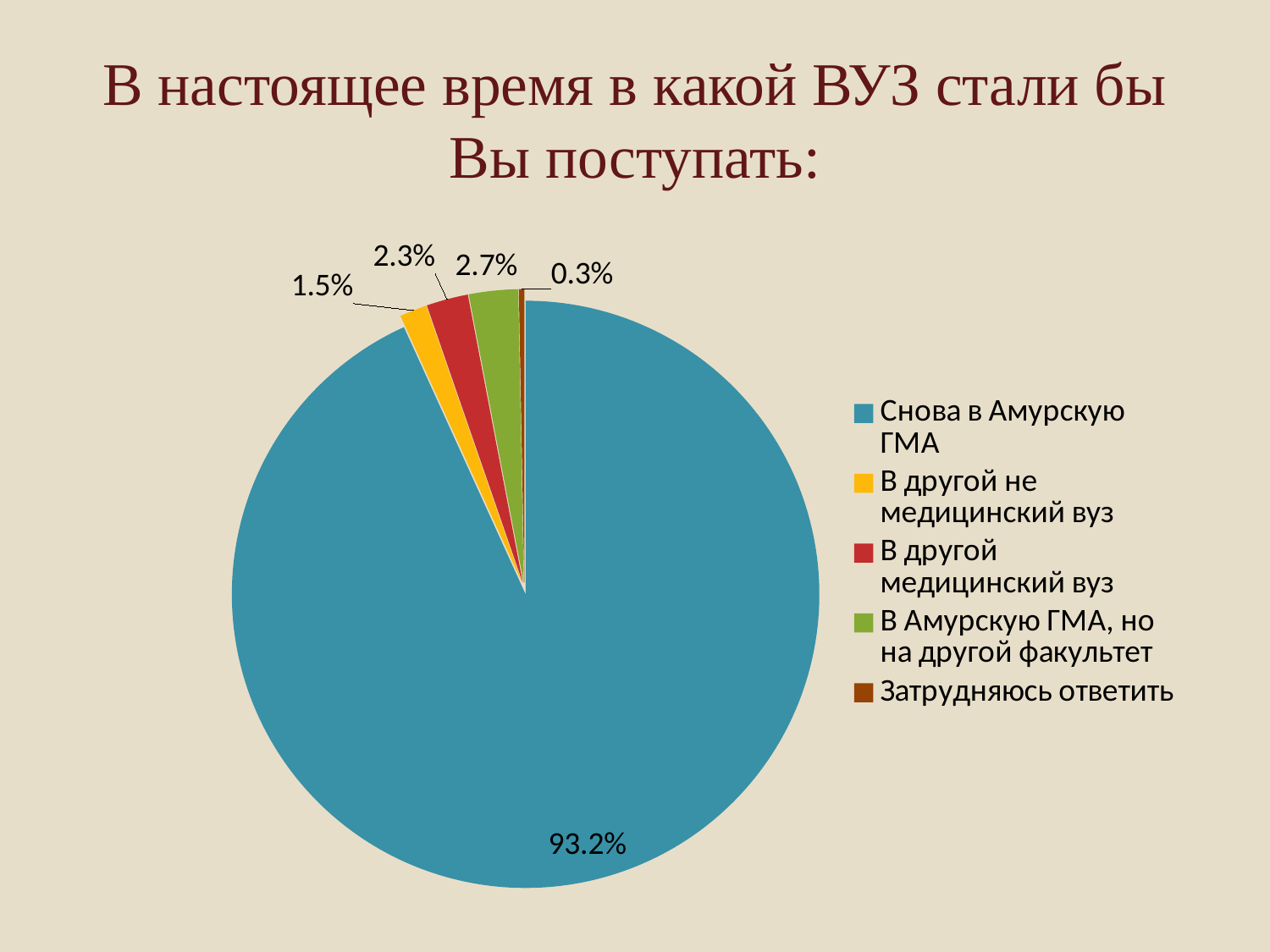
Which category has the smallest slice of the pie? Затрудняюсь ответить What share of respondents chose "В другой не медицинский вуз"? 1.5% How many categories does the pie chart have? 5 What share of respondents chose "Затрудняюсь ответить"? 0.3% Which category has the largest slice of the pie? Снова в Амурскую ГМА What colour is the slice for "Снова в Амурскую ГМА"? Blue What kind of chart is shown on the slide? Pie chart Which is larger: the share for "В другой медицинский вуз" or the share for "В другой не медицинский вуз"? В другой медицинский вуз What share of respondents chose "Снова в Амурскую ГМА"? 93.2% What is the difference between the share for "В Амурскую ГМА, но на другой факультет" and the share for "В другой медицинский вуз"? 0.4% What share of respondents chose "В другой медицинский вуз"? 2.3% What share of respondents chose "В Амурскую ГМА, но на другой факультет"? 2.7%